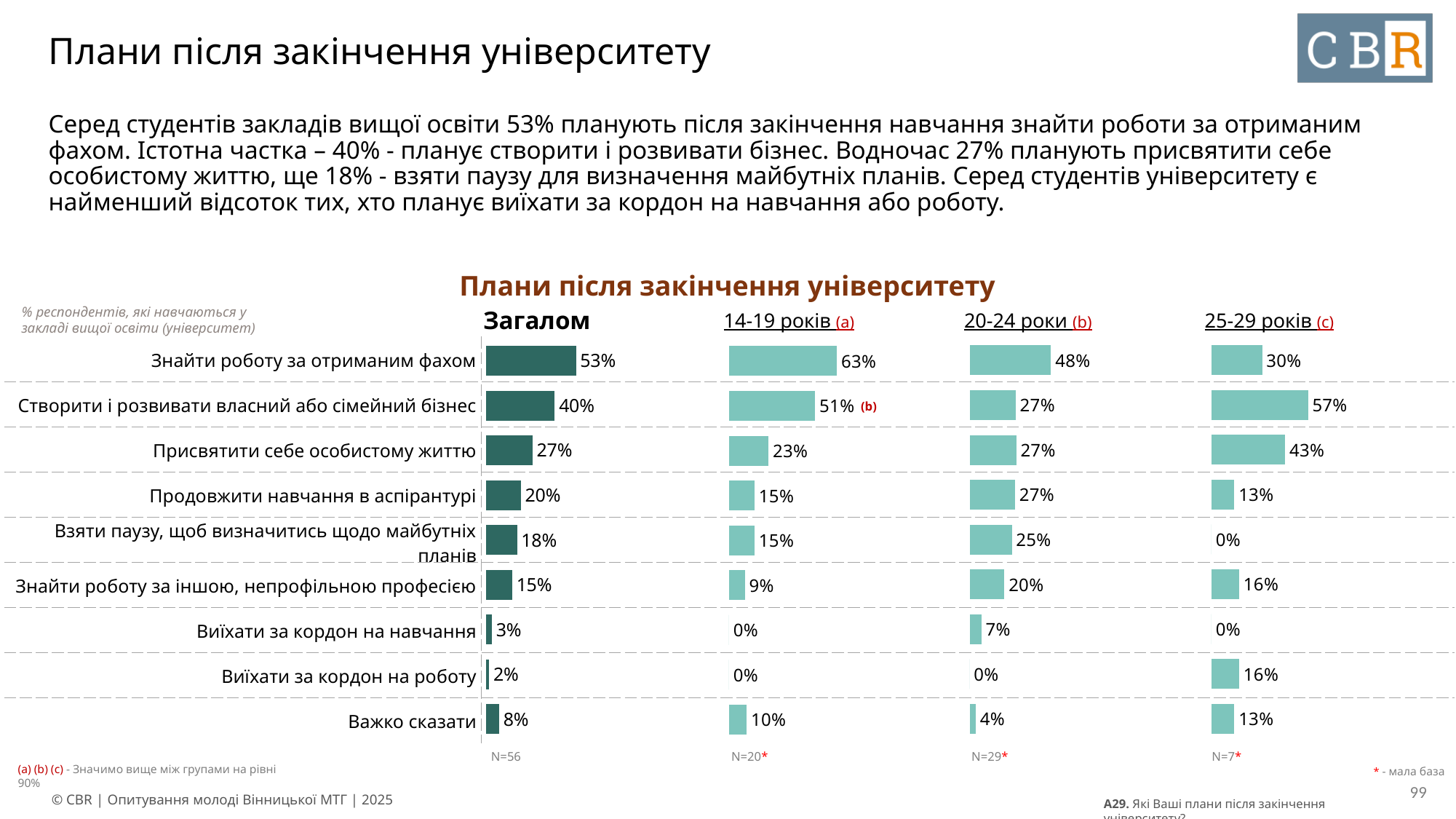
How many categories (plans) are listed in the chart? 9 What is the title of the chart? Плани після закінчення університету In the '20-24 роки' column, what is the value for 'Взяти паузу, щоб визначитись щодо майбутніх планів'? 25% In the '25-29 років' column, what is the value for 'Створити і розвивати власний або сімейний бізнес'? 57% For 'Присвятити себе особистому життю', which is larger: the '25-29 років' value or the '14-19 років' value? 25-29 років What type of chart is shown on the slide? Bar chart What is the difference between the '14-19 років' and '20-24 роки' values for 'Знайти роботу за отриманим фахом'? 15% In the '14-19 років' column, which category has the highest value? Знайти роботу за отриманим фахом In the 'Загалом' column, what is the value for 'Знайти роботу за отриманим фахом'? 53% What is the sample size (N) shown for the 'Загалом' column? N=56 How many respondent groups (columns) does the chart show? 4 In the 'Загалом' column, which category has the lowest value? Виїхати за кордон на роботу